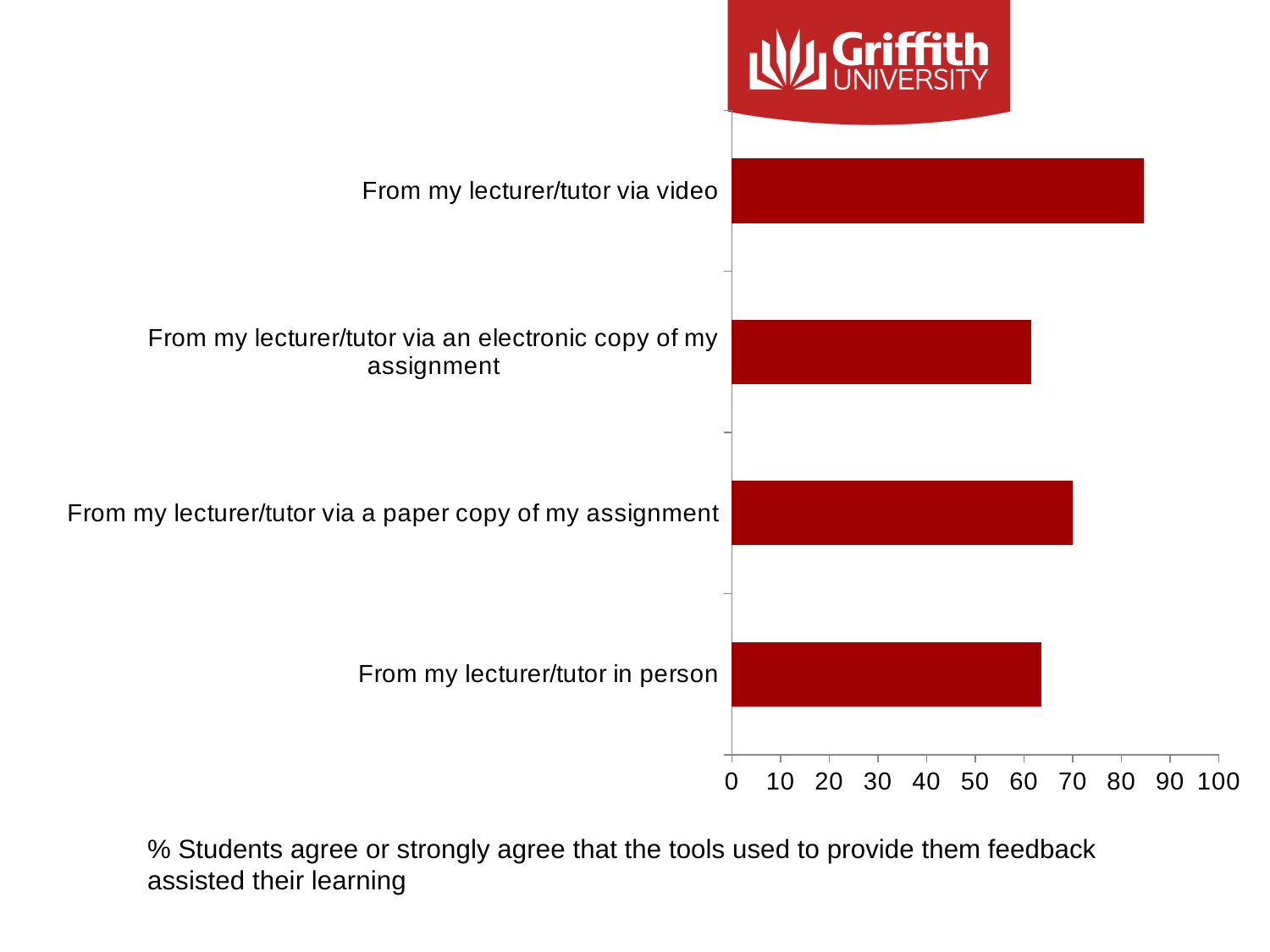
Is the value for "From my lecturer/tutor in person" greater or less than 70? less According to the caption below the chart, what do the bar values represent? % Students agree or strongly agree that the tools used to provide them feedback assisted their learning Which is larger: the value for "From my lecturer/tutor via a paper copy of my assignment" or for "From my lecturer/tutor in person"? From my lecturer/tutor via a paper copy of my assignment Is the value for "From my lecturer/tutor via video" greater or less than 80? greater Which is larger: the value for "From my lecturer/tutor via video" or for "From my lecturer/tutor via a paper copy of my assignment"? From my lecturer/tutor via video Is the value for "From my lecturer/tutor via a paper copy of my assignment" greater or less than 60? greater Which feedback source has the highest percentage of students agreeing it assisted their learning? From my lecturer/tutor via video What is the maximum value shown on the horizontal axis of the chart? 100 How many categories (feedback sources) are plotted in the chart? 4 What kind of chart is shown on the slide? bar chart